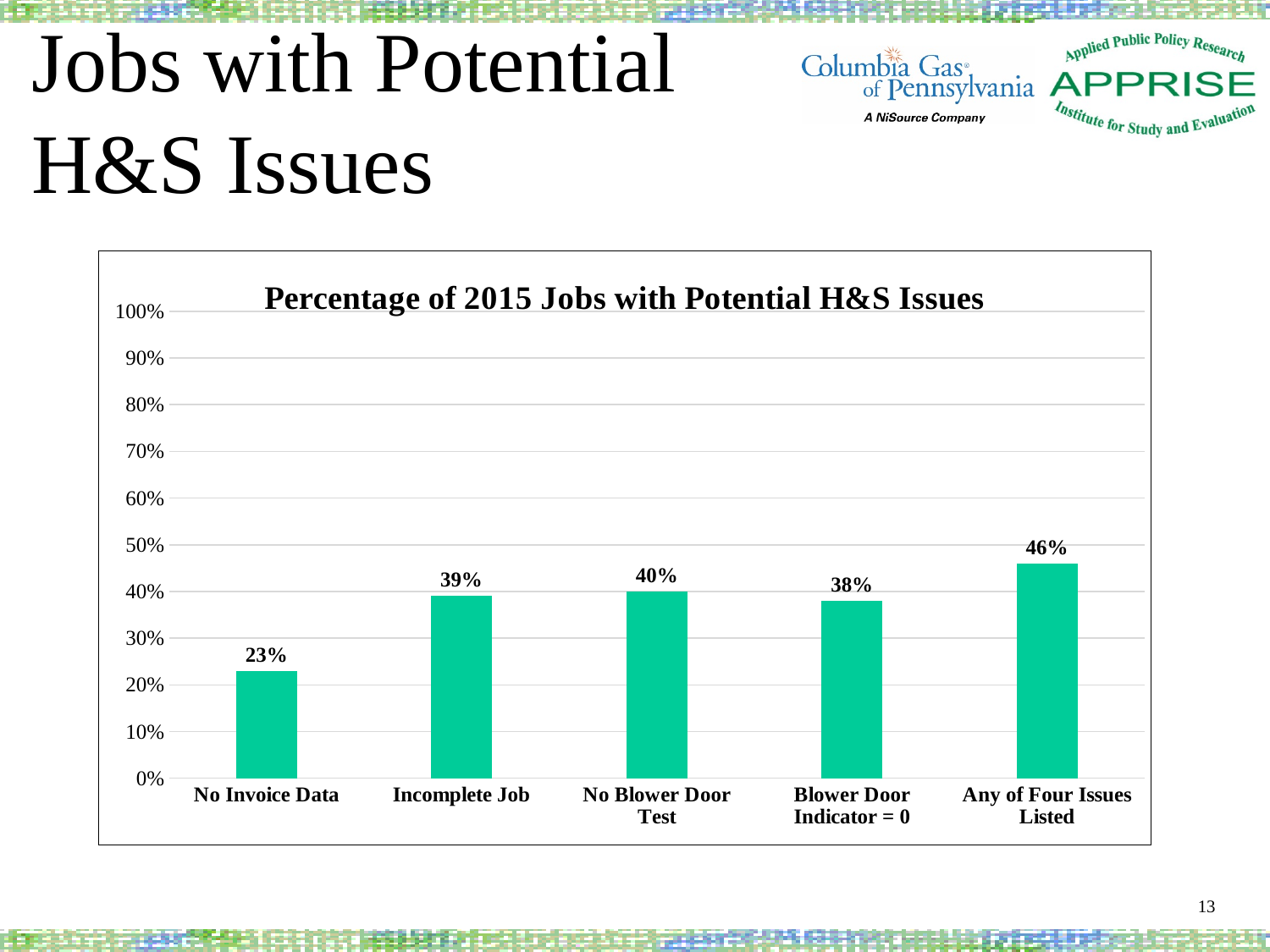
What percentage of 2015 jobs had No Invoice Data? 23% How many categories are shown on the x axis? 5 What is the value for Blower Door Indicator = 0? 38% What kind of chart is shown on the slide? Bar chart What is the value shown for Incomplete Job? 39% Which category has the highest percentage? Any of Four Issues Listed What percentage of jobs had No Blower Door Test? 40% Which is larger, the value for Incomplete Job or the value for Blower Door Indicator = 0? Incomplete Job What is the title of the chart? Percentage of 2015 Jobs with Potential H&S Issues Which category has the lowest percentage? No Invoice Data What percentage of jobs had Any of Four Issues Listed? 46% What is the difference between the values for Any of Four Issues Listed and No Invoice Data? 23%